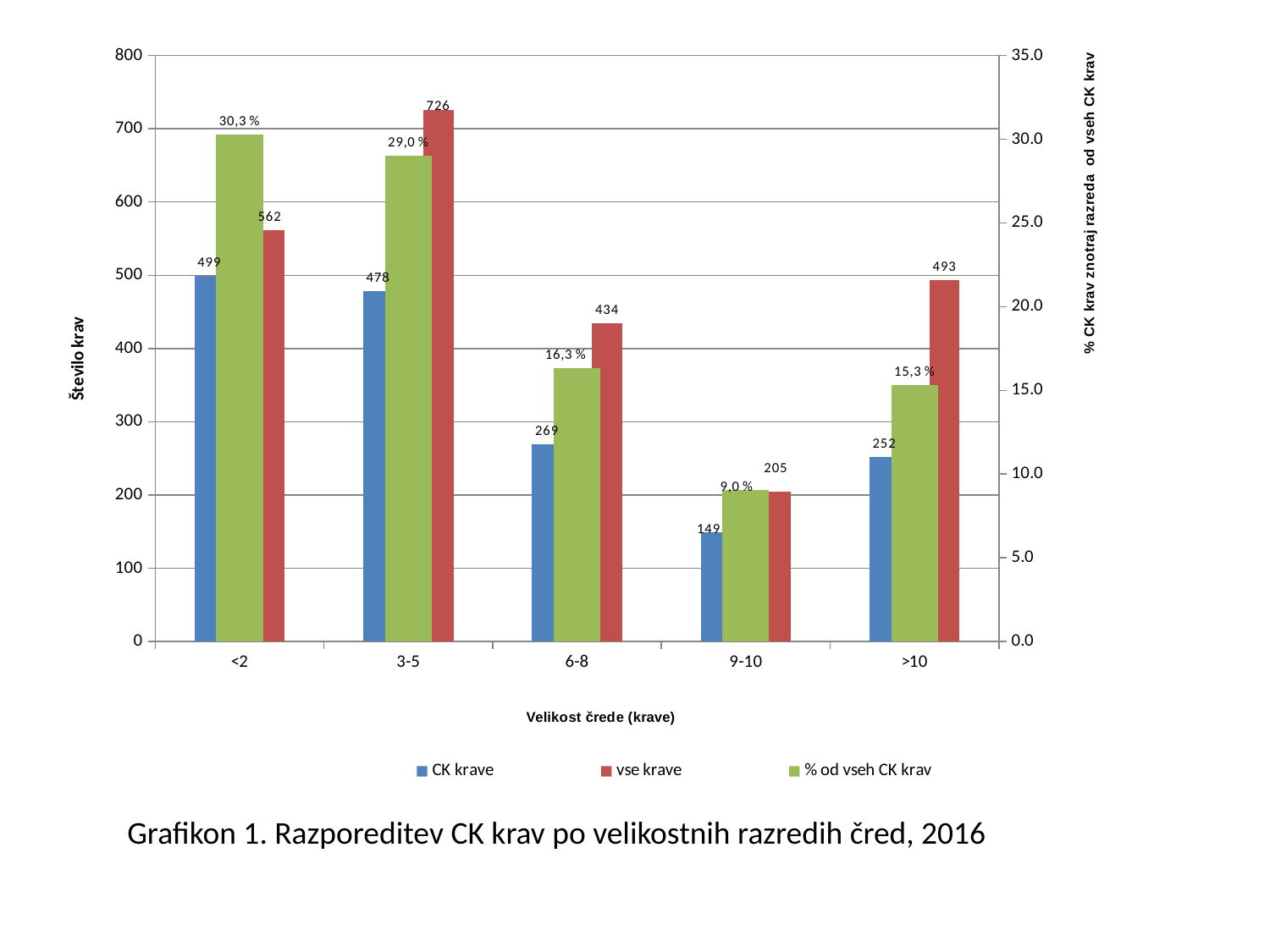
What is the value of vse krave for the >10 category? 493 What is the value of vse krave for the 3-5 herd size category? 726 Which herd size category has the lowest value for CK krave? 9-10 What is the difference between vse krave and CK krave in the 6-8 category? 165 What is the value of CK krave for the <2 herd size category? 499 How many herd size categories are shown on the x axis? 5 What is the label of the left vertical axis? Število krav What percentage (% od vseh CK krav) is shown for the 6-8 category? 16,3 % Which is larger: CK krave for <2 or CK krave for 3-5? CK krave for <2 Which herd size category has the highest value for vse krave? 3-5 What kind of chart is shown on the slide? Bar chart How many series does the legend list? 3